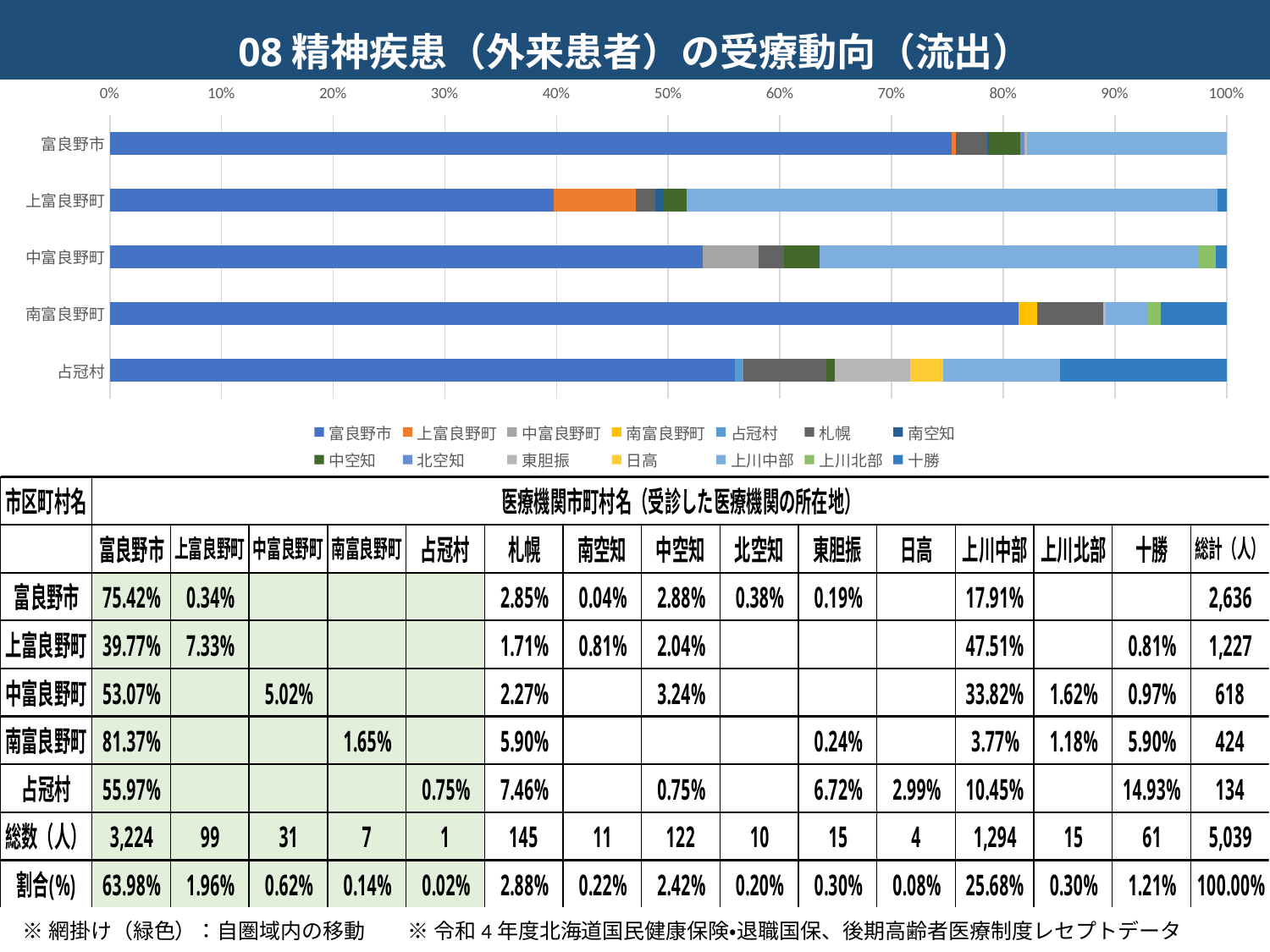
What is the difference between the 富良野市 share for 南富良野町 (81.37%) and for 占冠村 (55.97%)? 25.40% Which has a larger 上川中部 share, 上富良野町 or 中富良野町? 上富良野町 Which municipality has the highest share of outpatients receiving care in 富良野市? 南富良野町 What kind of chart is shown on the slide? bar chart What is the title of the chart? 08 精神疾患（外来患者）の受療動向（流出） How many series does the chart legend list? 14 What share of 富良野市 outpatients received care in 上川中部? 17.91% How many municipalities (categories) are plotted on the y axis of the chart? 5 What share of 上富良野町 outpatients received care in 富良野市? 39.77% Is the 富良野市 segment for 占冠村 greater or less than 50%? greater Which municipality has the lowest share of outpatients receiving care in 富良野市? 上富良野町 What share of 占冠村 outpatients received care in 十勝? 14.93%